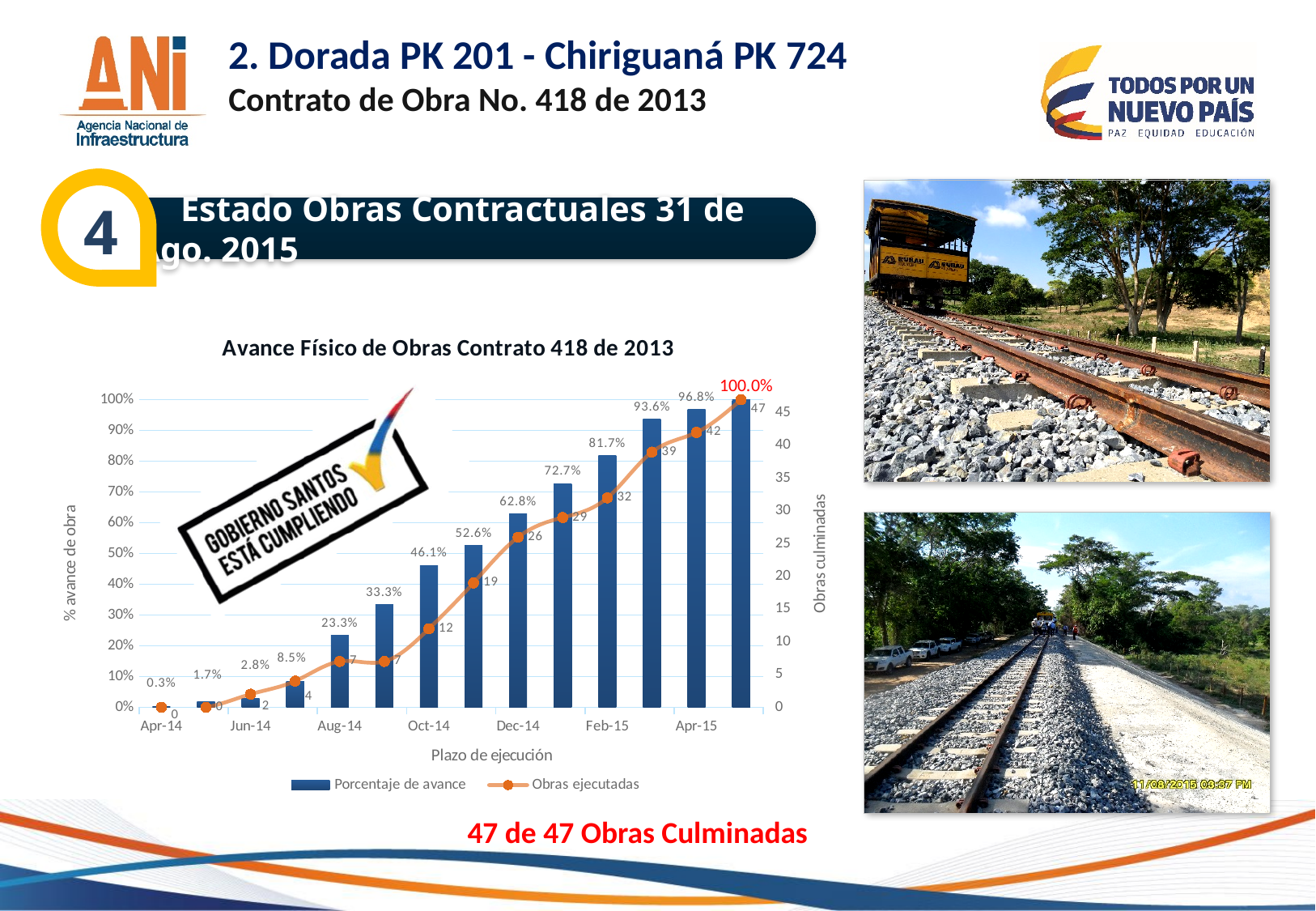
Do the Porcentaje de avance values rise or fall from Apr-14 to Apr-15? Rise How many Obras ejecutadas are shown for Oct-14? 12 How many Obras ejecutadas are shown for Apr-15? 42 How many series does the chart legend list? 2 Which has a higher Porcentaje de avance, Apr-15 or Feb-15? Apr-15 What is the difference in Obras ejecutadas between Feb-15 and Dec-14? 6 How many Obras ejecutadas are shown for Dec-14? 26 What is the highest value reached by the Porcentaje de avance series? 100.0% What is the Porcentaje de avance for Aug-14? 23.3% What is the Porcentaje de avance for Feb-15? 81.7% What kind of chart is shown on the slide? Combined bar and line chart What is the title of the chart? Avance Físico de Obras Contrato 418 de 2013